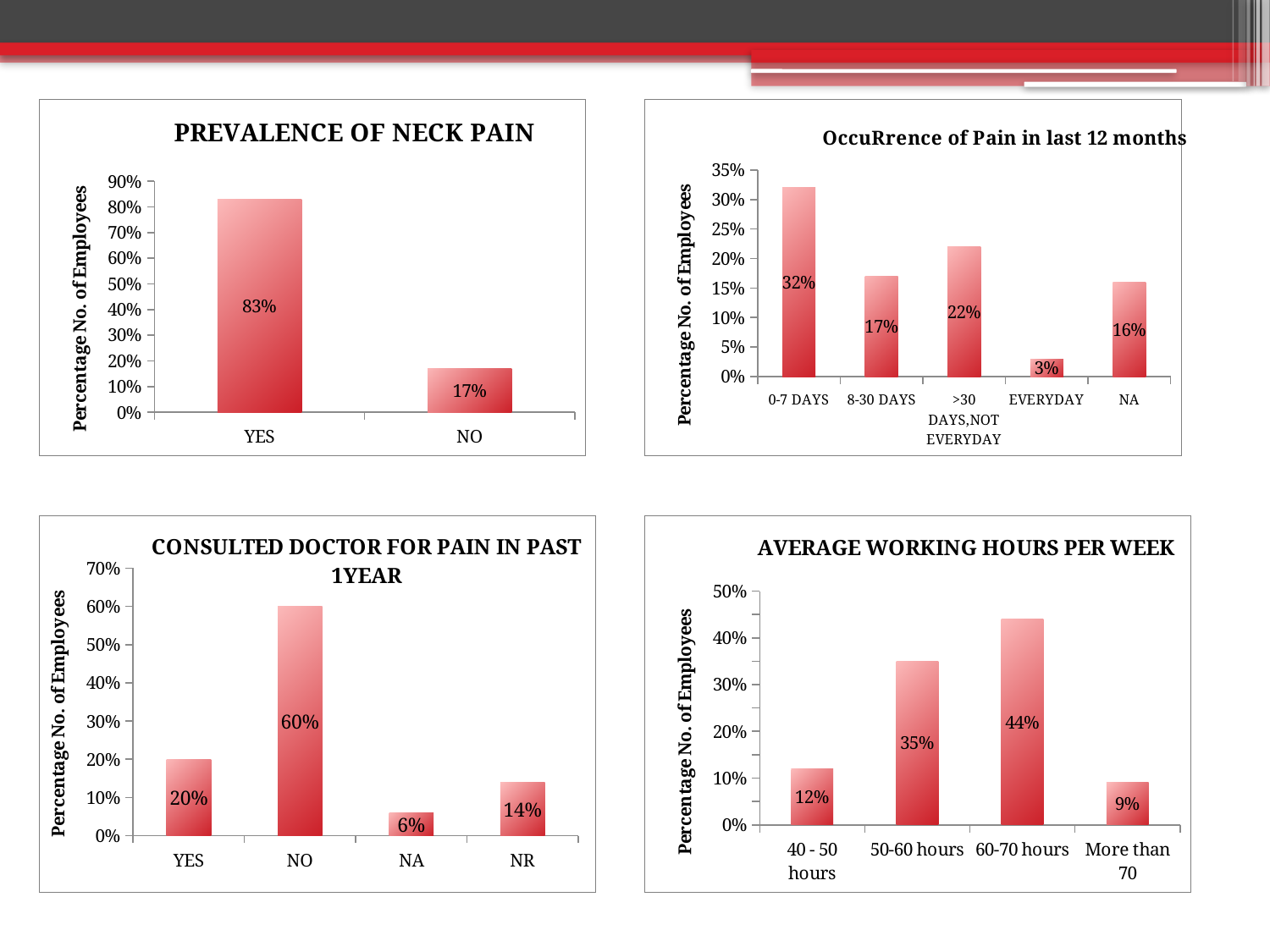
In the 'CONSULTED DOCTOR FOR PAIN IN PAST 1YEAR' chart, which is larger, YES or NA? YES In the 'PREVALENCE OF NECK PAIN' chart, what is the value for YES? 83% How many categories are shown in the 'OccuRrence of Pain in last 12 months' chart? 5 What type of chart is the 'AVERAGE WORKING HOURS PER WEEK' chart? Bar chart In the 'OccuRrence of Pain in last 12 months' chart, which category has the lowest value? EVERYDAY In the 'CONSULTED DOCTOR FOR PAIN IN PAST 1YEAR' chart, what is the difference between NO and YES? 40% In the 'OccuRrence of Pain in last 12 months' chart, which category has the highest value? 0-7 DAYS In the 'OccuRrence of Pain in last 12 months' chart, what is the value for 8-30 DAYS? 17% In the 'CONSULTED DOCTOR FOR PAIN IN PAST 1YEAR' chart, what is the value for NR? 14% In the 'AVERAGE WORKING HOURS PER WEEK' chart, what is the value for 50-60 hours? 35% In the 'AVERAGE WORKING HOURS PER WEEK' chart, which category has the highest value? 60-70 hours In the 'PREVALENCE OF NECK PAIN' chart, what is the difference between the YES and NO values? 66%